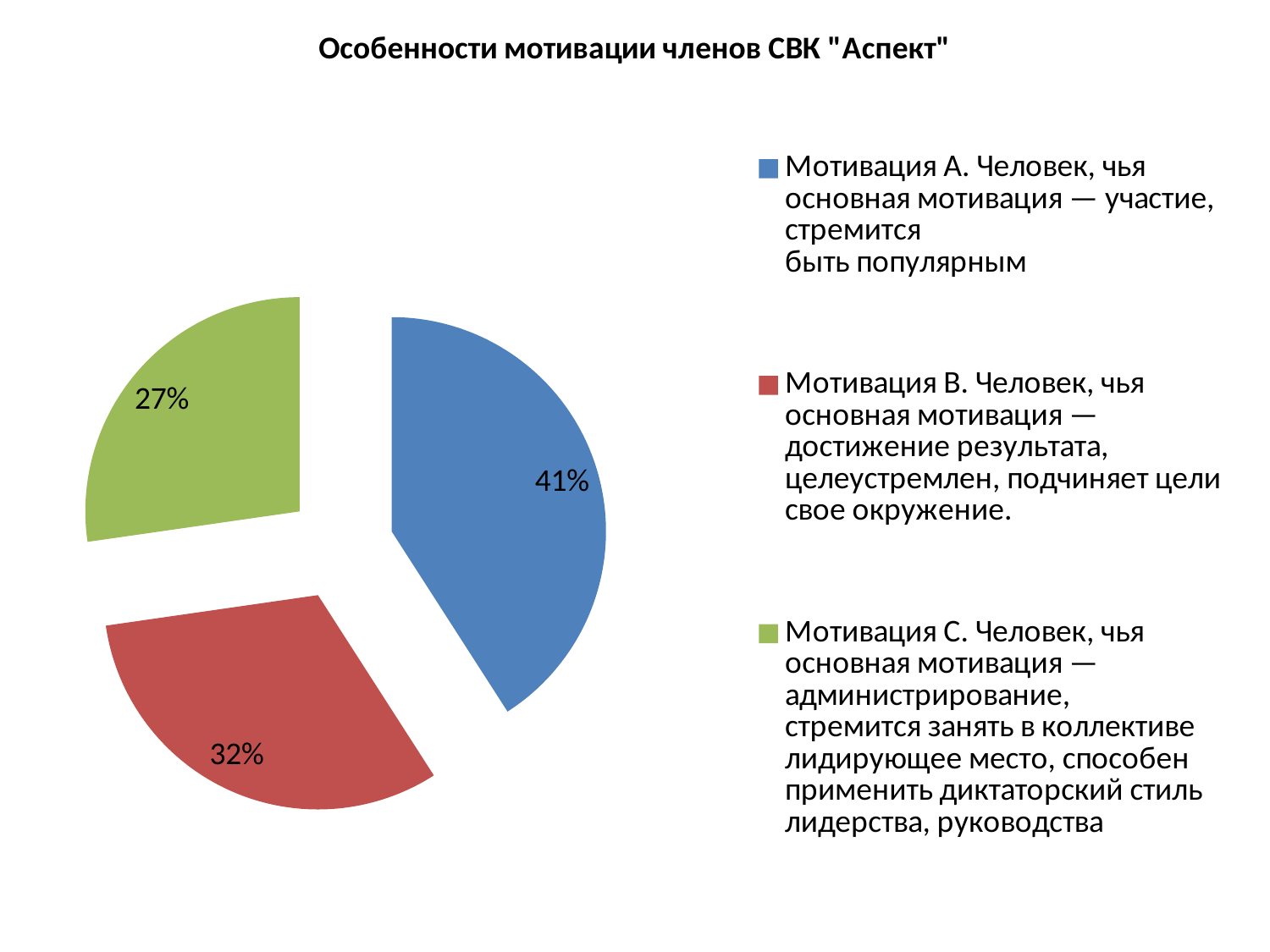
What share of the pie does Мотивация В (red slice) have? 32% Which motivation type has the smallest share of the pie? Мотивация С What share of the pie does Мотивация С (green slice) have? 27% What is the difference in percentage points between the shares of Мотивация В and Мотивация С? 5 What share of the pie does Мотивация А (blue slice) have? 41% Which motivation type has the largest share of the pie? Мотивация А What is the difference in percentage points between the shares of Мотивация А and Мотивация С? 14 How many slices does the pie chart have? 3 What colour is the slice for Мотивация С? green What is the title of the chart? Особенности мотивации членов СВК "Аспект" What kind of chart is shown on the slide? pie chart Which has a larger share, Мотивация В or Мотивация С? Мотивация В